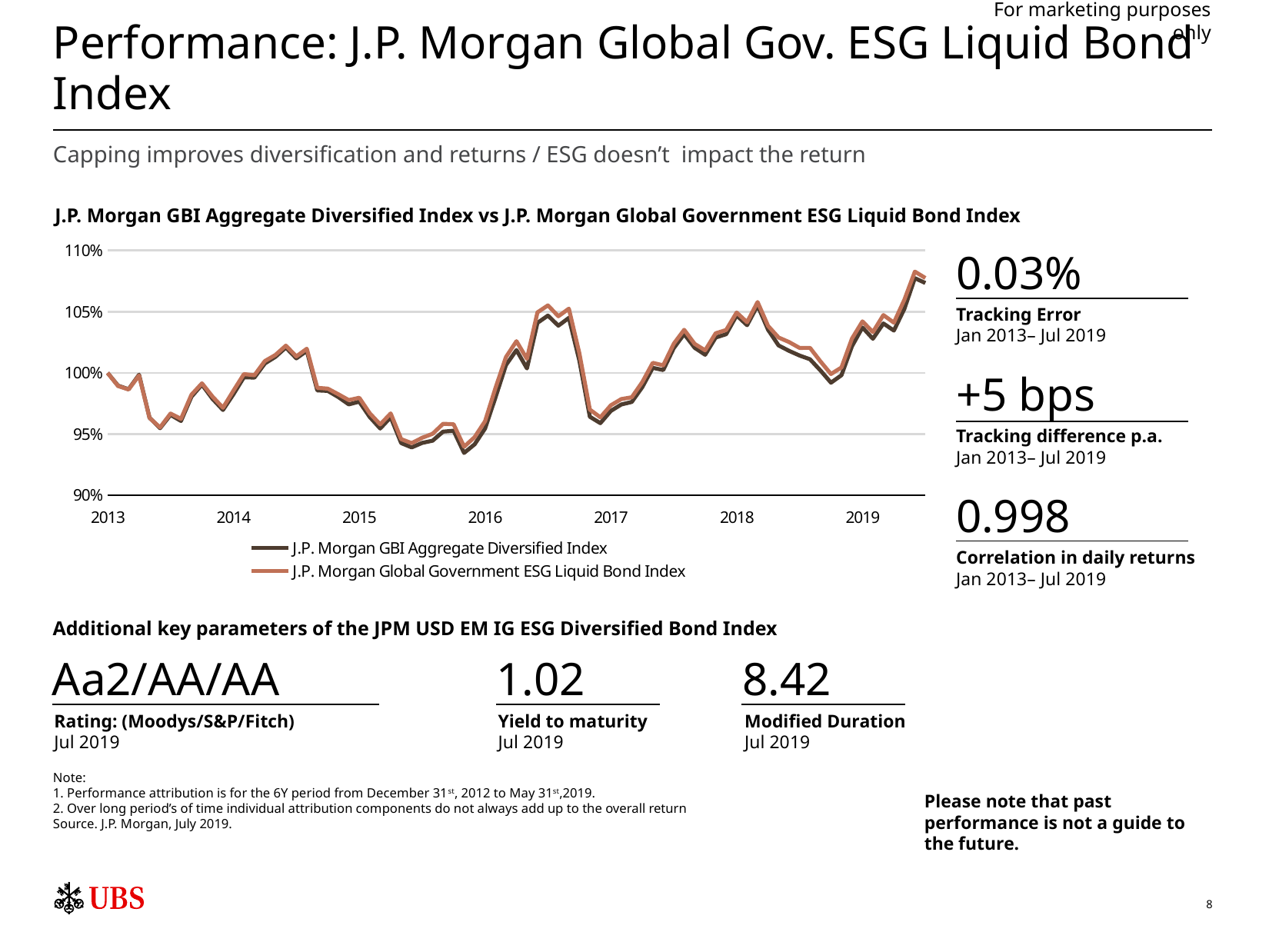
Do the index values in the chart rise or fall overall from 2013 to the end of the series in 2019? rise How many series does the chart legend list? 2 What value do both series start at in 2013 on the chart? 100% How many year labels are shown on the chart's x axis? 7 What is the highest value shown on the chart's vertical axis? 110% Which series is drawn in the lighter orange line in the chart? J.P. Morgan Global Government ESG Liquid Bond Index Is the value of the J.P. Morgan Global Government ESG Liquid Bond Index at the end of the series in 2019 greater or less than 105%? greater Is the lowest point of the J.P. Morgan GBI Aggregate Diversified Index, reached in early 2016, greater or less than 95%? less What kind of chart is shown on the slide? line chart Is the value of the J.P. Morgan GBI Aggregate Diversified Index at the start of 2018 greater or less than 100%? greater What is the title of the chart? J.P. Morgan GBI Aggregate Diversified Index vs J.P. Morgan Global Government ESG Liquid Bond Index